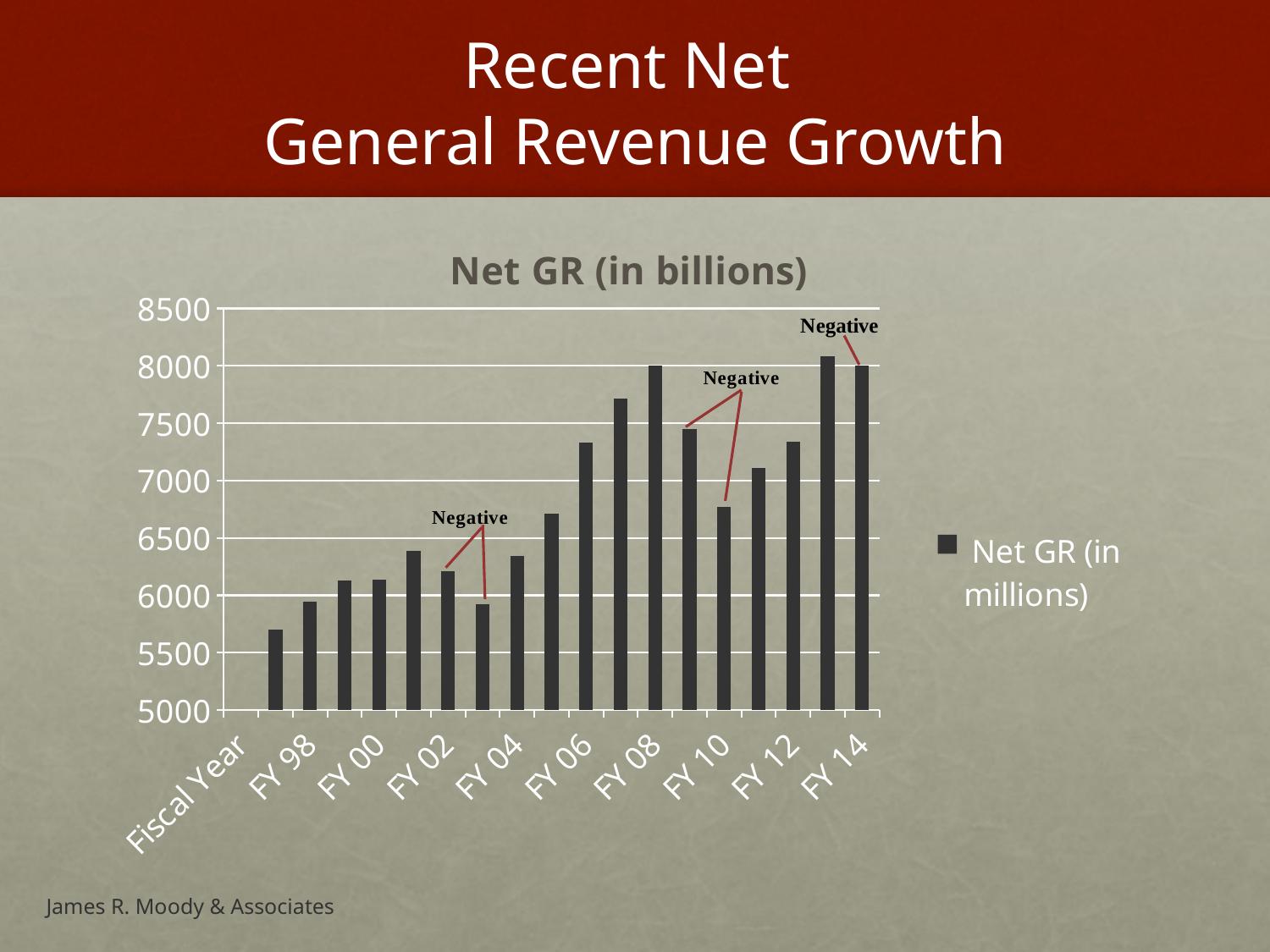
Which is larger, the value for FY 06 or the value for FY 10? FY 06 Overall, do the values rise or fall from the first bar to the last bar along the x axis? rise What kind of chart is shown on the slide? bar chart What is the title of the chart? Net GR (in billions) What is the legend entry for the series? Net GR (in millions) Is the value for FY 06 greater or less than 7000? greater Is the value for FY 10 greater or less than 7000? less How many bars are plotted in the chart? 18 Is the value for FY 00 greater or less than 6000? greater How many series does the legend list? 1